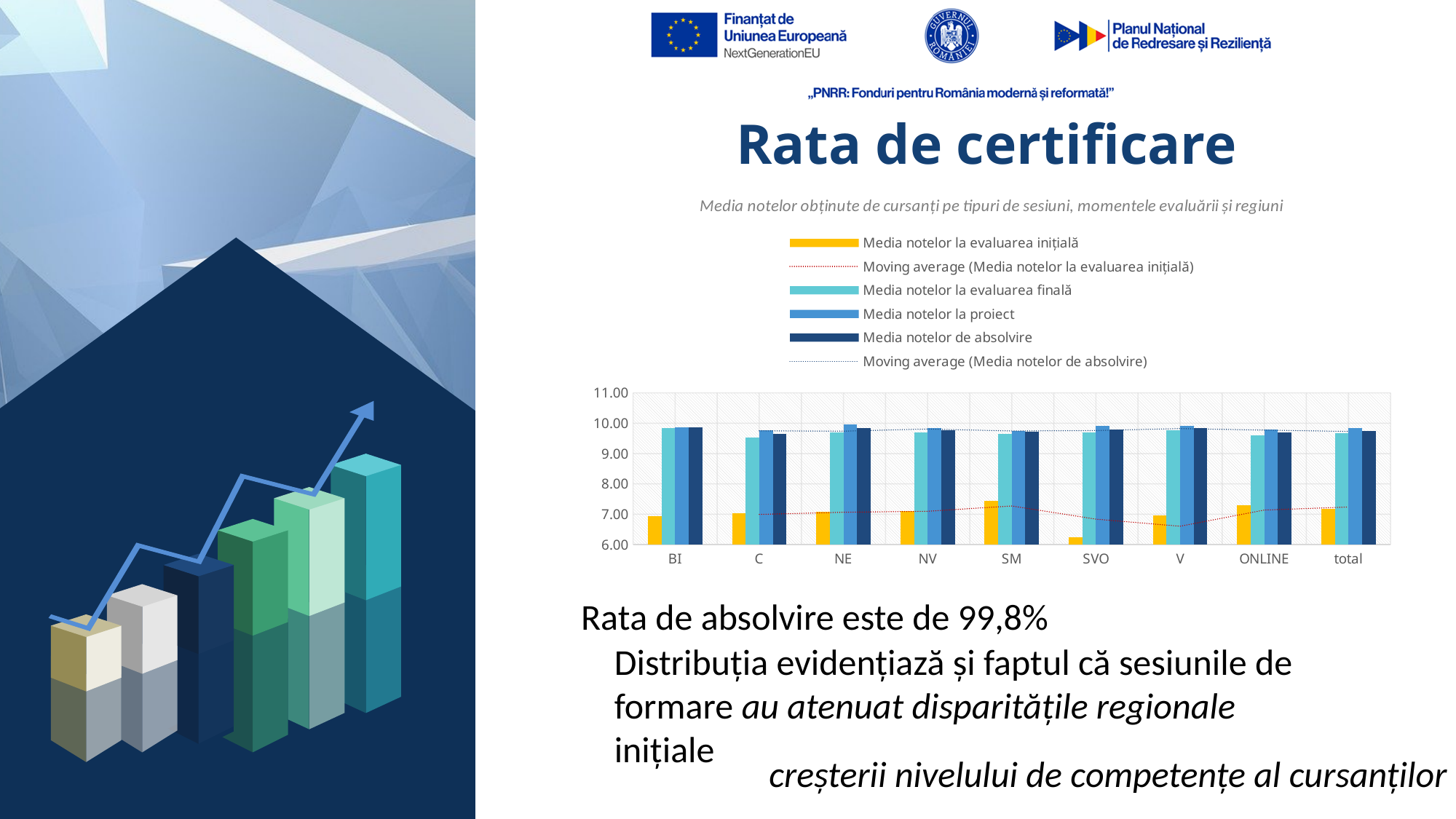
Is the value for 'Media notelor la evaluarea inițială' for SVO greater or less than 7.00? less What colour represents 'Media notelor la evaluarea inițială' in the chart? yellow Which is larger: the 'Media notelor la evaluarea inițială' value for SM or for SVO? SM How many categories are shown along the x axis of the chart? 9 Is the value for 'Media notelor la proiect' for NE greater or less than 9.00? greater Which category has the lowest value for 'Media notelor la evaluarea inițială'? SVO How many entries does the chart's legend list? 6 What is the subtitle (chart title) printed above the legend? Media notelor obținute de cursanți pe tipuri de sesiuni, momentele evaluării și regiuni Is the value for 'Media notelor la evaluarea finală' for BI greater or less than 9.00? greater Which category has the highest value for 'Media notelor la evaluarea inițială'? SM What kind of chart is shown on the slide? bar chart